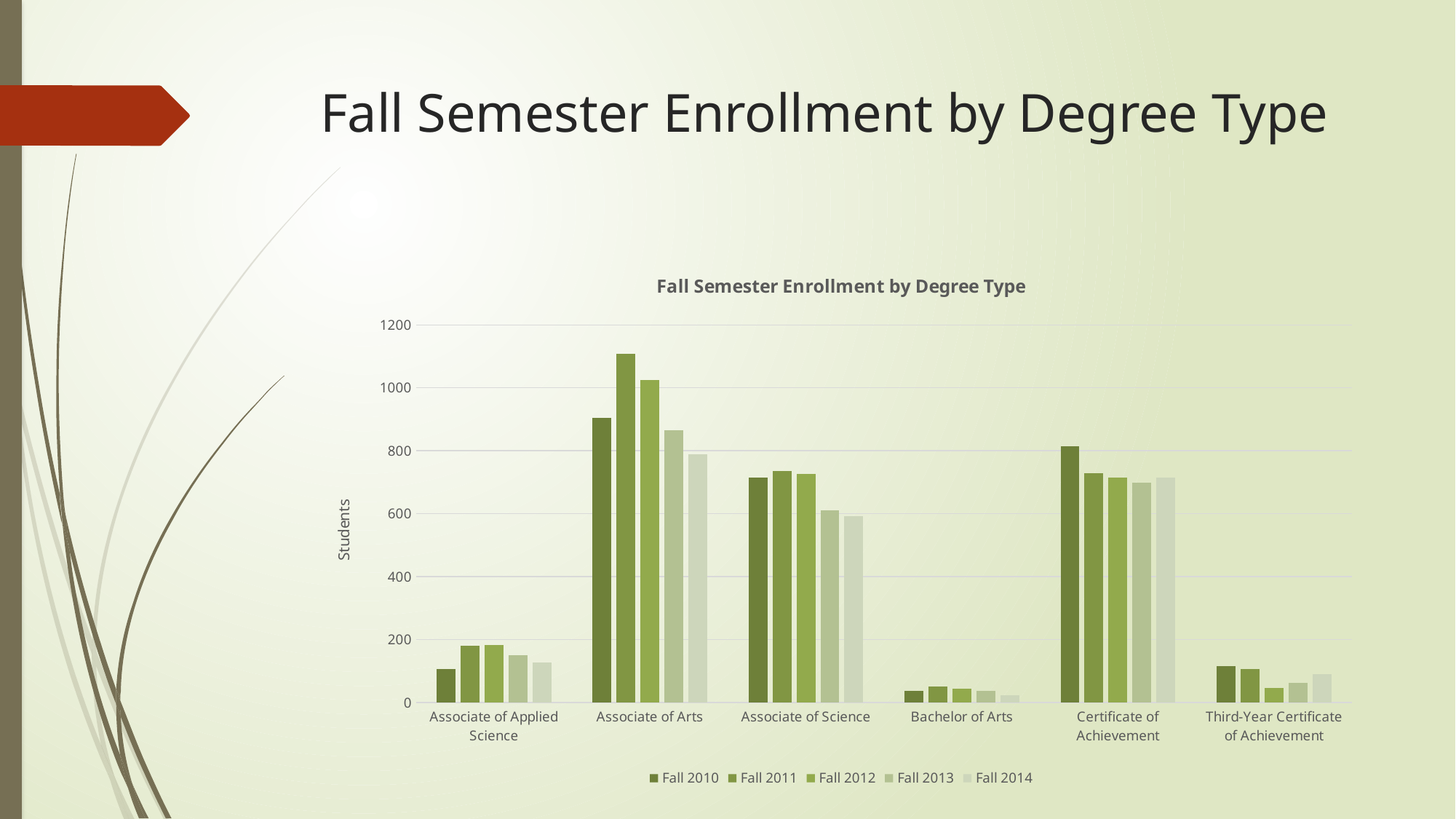
How many series does the legend list? 5 How many degree-type categories are shown on the x axis? 6 Is the Fall 2014 value for Associate of Applied Science greater or less than 200? less For Associate of Arts, which fall semester has the highest enrollment? Fall 2011 From Fall 2011 to Fall 2014, does the enrollment for Associate of Arts rise or fall? fall Is the Fall 2011 value for Associate of Arts greater or less than 1000? greater Which degree type has the highest Fall 2011 enrollment? Associate of Arts What is the label on the vertical axis of the chart? Students Which degree type has the lowest Fall 2014 enrollment? Bachelor of Arts Is the Fall 2010 value for Certificate of Achievement greater or less than 600? greater Which is larger for Fall 2010: Associate of Arts or Certificate of Achievement? Associate of Arts What kind of chart is shown on the slide? bar chart